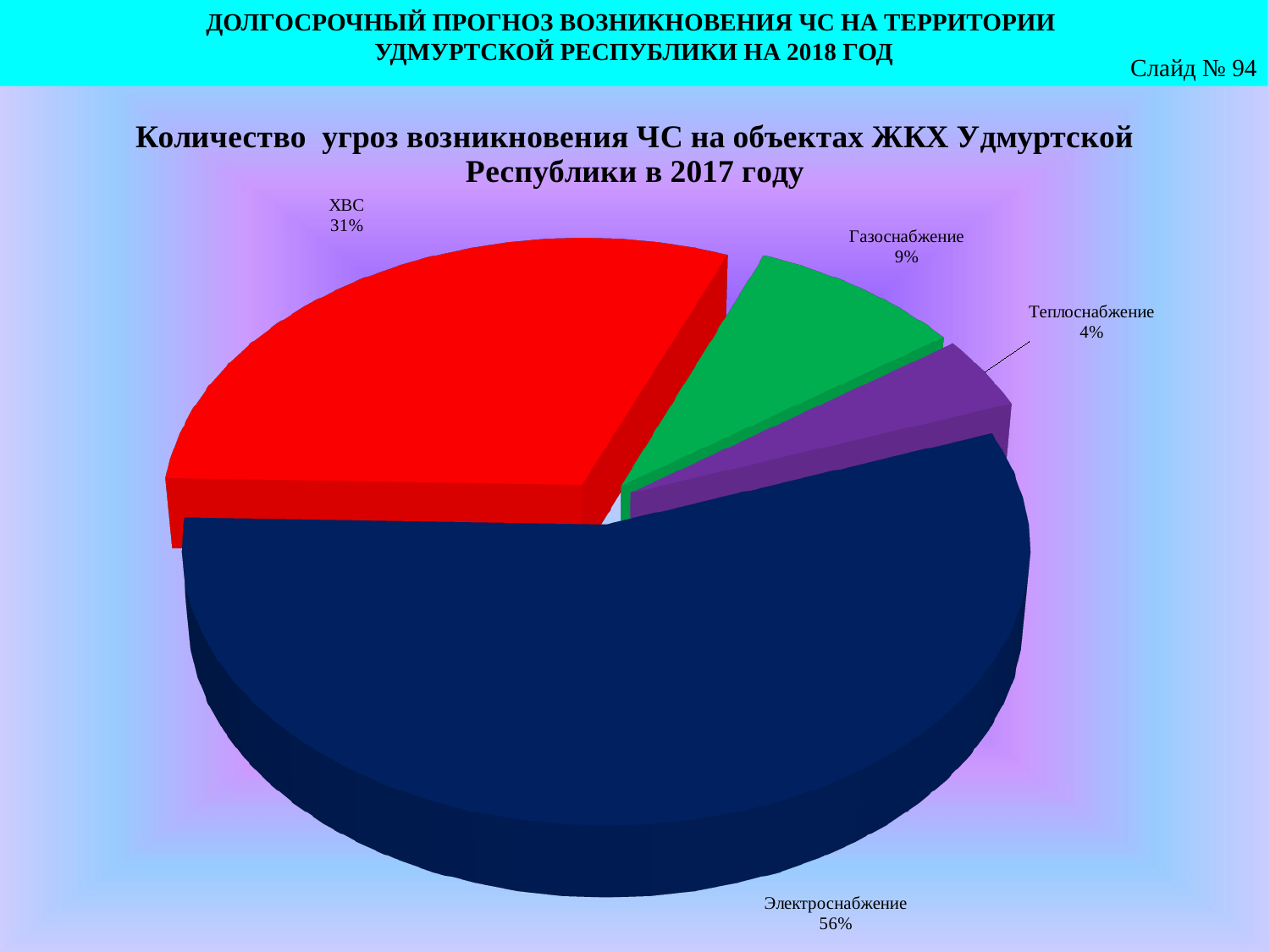
What is the title of the chart? Количество угроз возникновения ЧС на объектах ЖКХ Удмуртской Республики в 2017 году What share of the pie does ХВС have? 31% What colour is the slice for ХВС? red What share of the pie does Газоснабжение have? 9% What share of the pie does Теплоснабжение have? 4% Which category has the largest share of the pie? Электроснабжение How many categories (slices) does the pie chart have? 4 Which is larger, the share for Газоснабжение or the share for Теплоснабжение? Газоснабжение What kind of chart is shown on the slide? pie chart Which category has the smallest share of the pie? Теплоснабжение What is the difference in percentage points between Электроснабжение and ХВС? 25